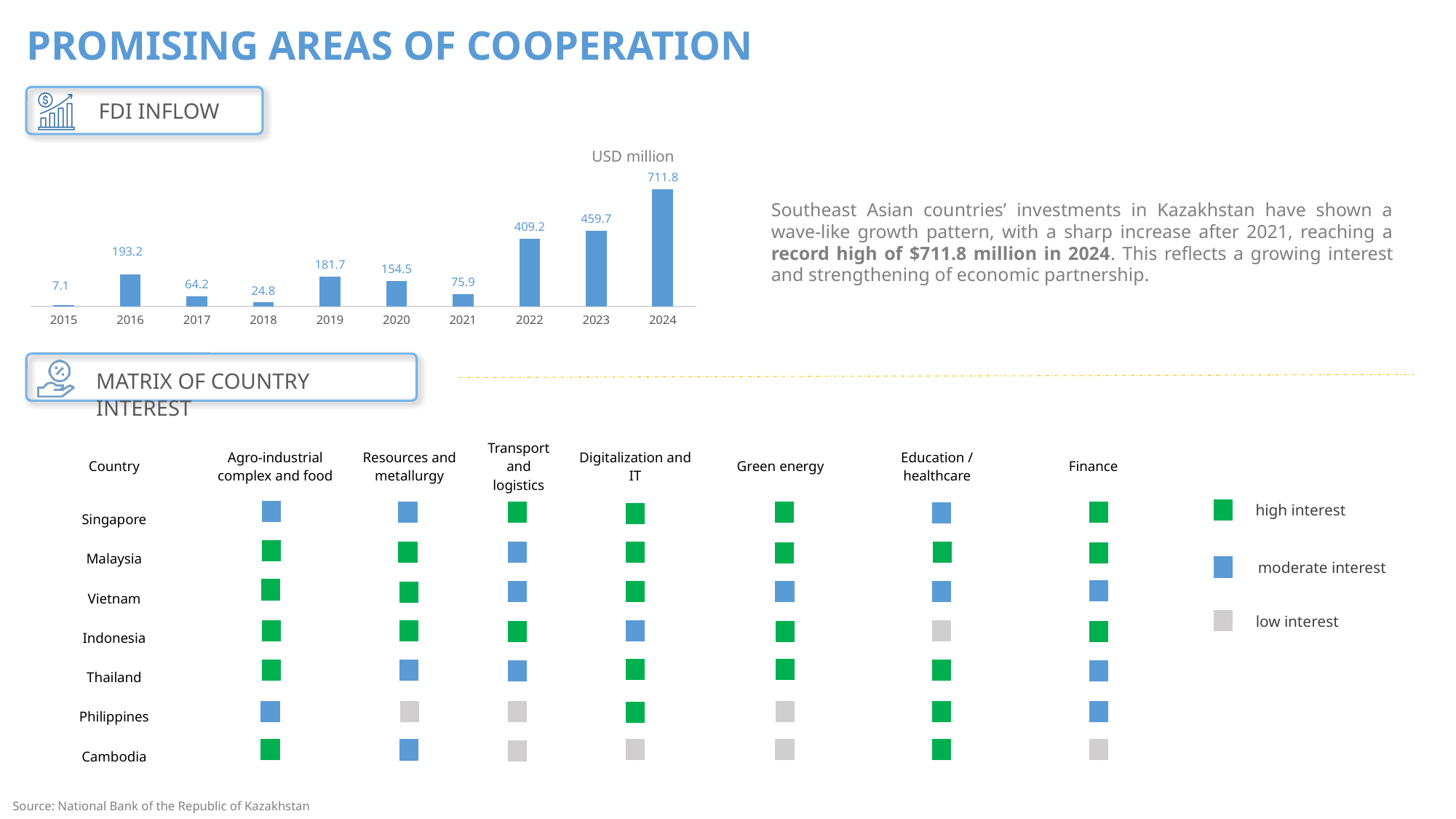
What unit is shown above the FDI inflow chart? USD million In the FDI inflow chart, what is the value for 2018? 24.8 In the FDI inflow chart, what is the difference between the values for 2024 and 2023? 252.1 In the FDI inflow chart, which is larger, the value for 2019 or the value for 2021? 2019 In the FDI inflow chart, which year has the highest value? 2024 In the FDI inflow chart, what is the difference between the values for 2016 and 2017? 129.0 How many years are shown in the FDI inflow chart? 10 In the FDI inflow chart, do the values rise or fall from 2021 to 2024? rise In the FDI inflow chart, what is the value for 2022? 409.2 In the FDI inflow chart, which year has the lowest value? 2015 What kind of chart is the FDI inflow chart? bar chart In the FDI inflow chart, what is the value for 2020? 154.5